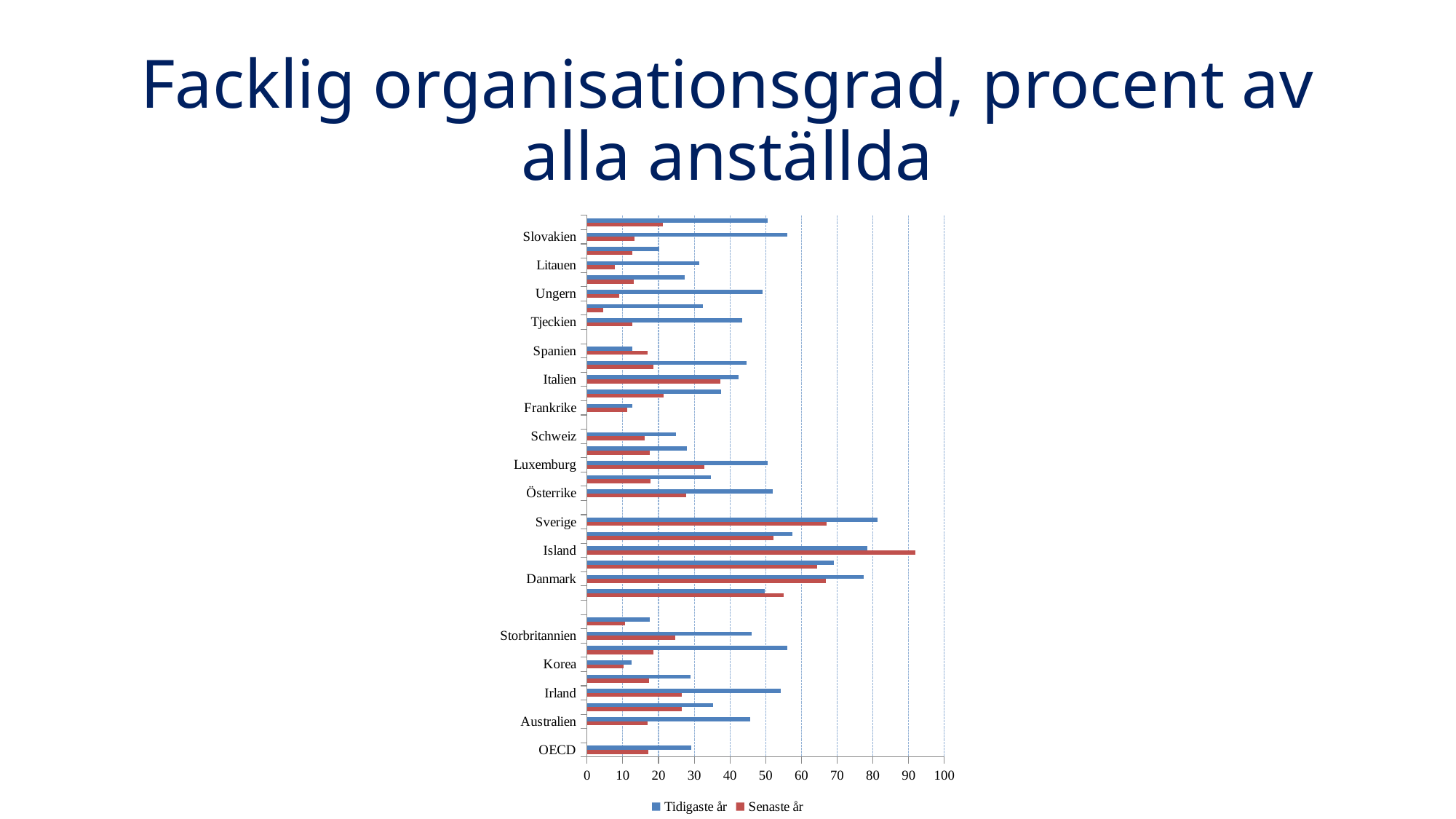
For Tjeckien, which is larger: the Tidigaste år value or the Senaste år value? Tidigaste år How many series does the legend list? 2 What are the two series named in the legend? Tidigaste år and Senaste år For Island, which is larger: the Tidigaste år value or the Senaste år value? Senaste år Is the Tidigaste år value for Irland greater or less than 50? greater Is the Tidigaste år value for OECD greater or less than 20? greater Is the Senaste år value for Island greater or less than 80? greater What kind of chart is shown on the slide? bar chart Which country has the highest value for Senaste år? Island Which colour represents the series Senaste år? red